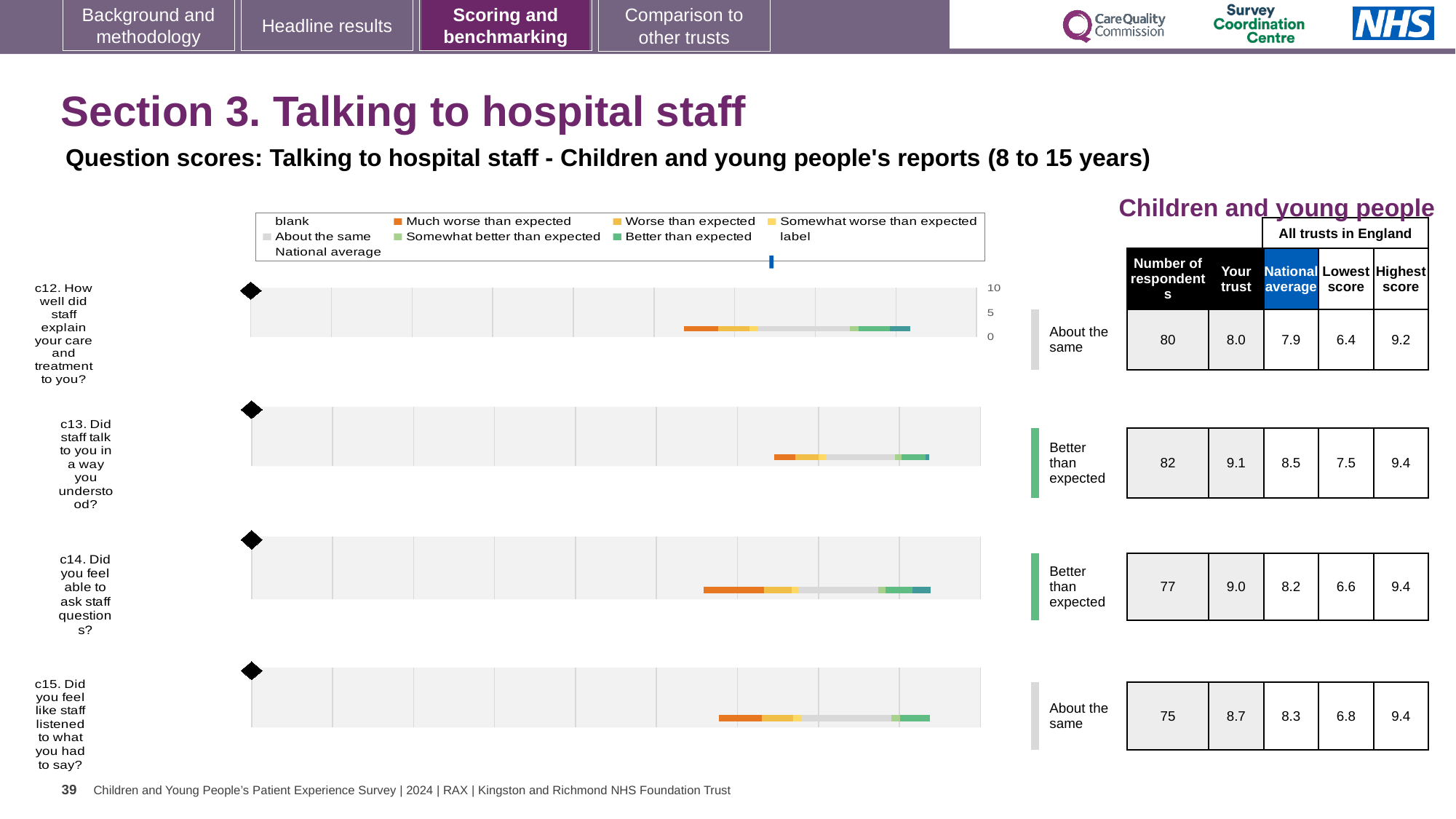
Which question has the lowest number of respondents? c15 How many survey questions (chart rows) are shown on the slide? 4 How many respondents answered c14 (Did you feel able to ask staff questions?)? 77 What benchmark category is shown for c13 (Did staff talk to you in a way you understood?)? Better than expected What is the difference between the 'Your trust' score and the national average for c13? 0.6 What is the 'Your trust' score for c12 (How well did staff explain your care and treatment to you?)? 8.0 What is the national average score for c13 (Did staff talk to you in a way you understood?)? 8.5 In the chart legend, what colour represents 'Much worse than expected'? orange What kind of chart is used to show the benchmarking results for questions c12 to c15? bar chart For c14, which is larger: the 'Your trust' score or the national average? Your trust What is the lowest score across all trusts in England for c15 (Did you feel like staff listened to what you had to say?)? 6.8 Which question has the highest 'Your trust' score? c13